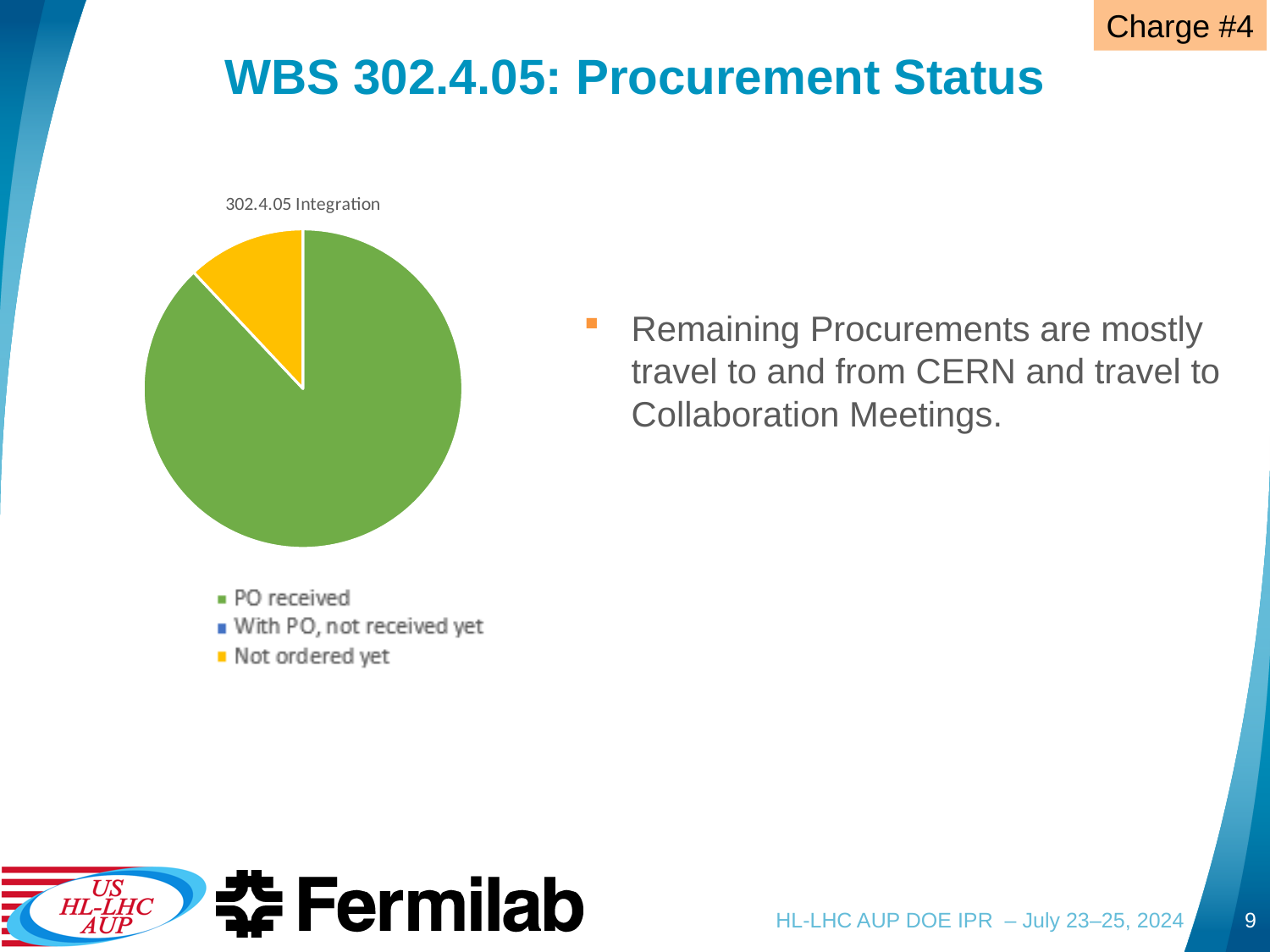
How many slices are visibly drawn in the pie chart? 2 Which category has the largest slice of the pie chart? PO received Which is larger in the pie chart, the slice for PO received or the slice for Not ordered yet? PO received Which legend category of the pie chart is shown in yellow? Not ordered yet What is the title of the pie chart? 302.4.05 Integration What colour represents the PO received category in the pie chart? green What kind of chart is shown on the slide? pie chart How many entries does the legend of the pie chart list? 3